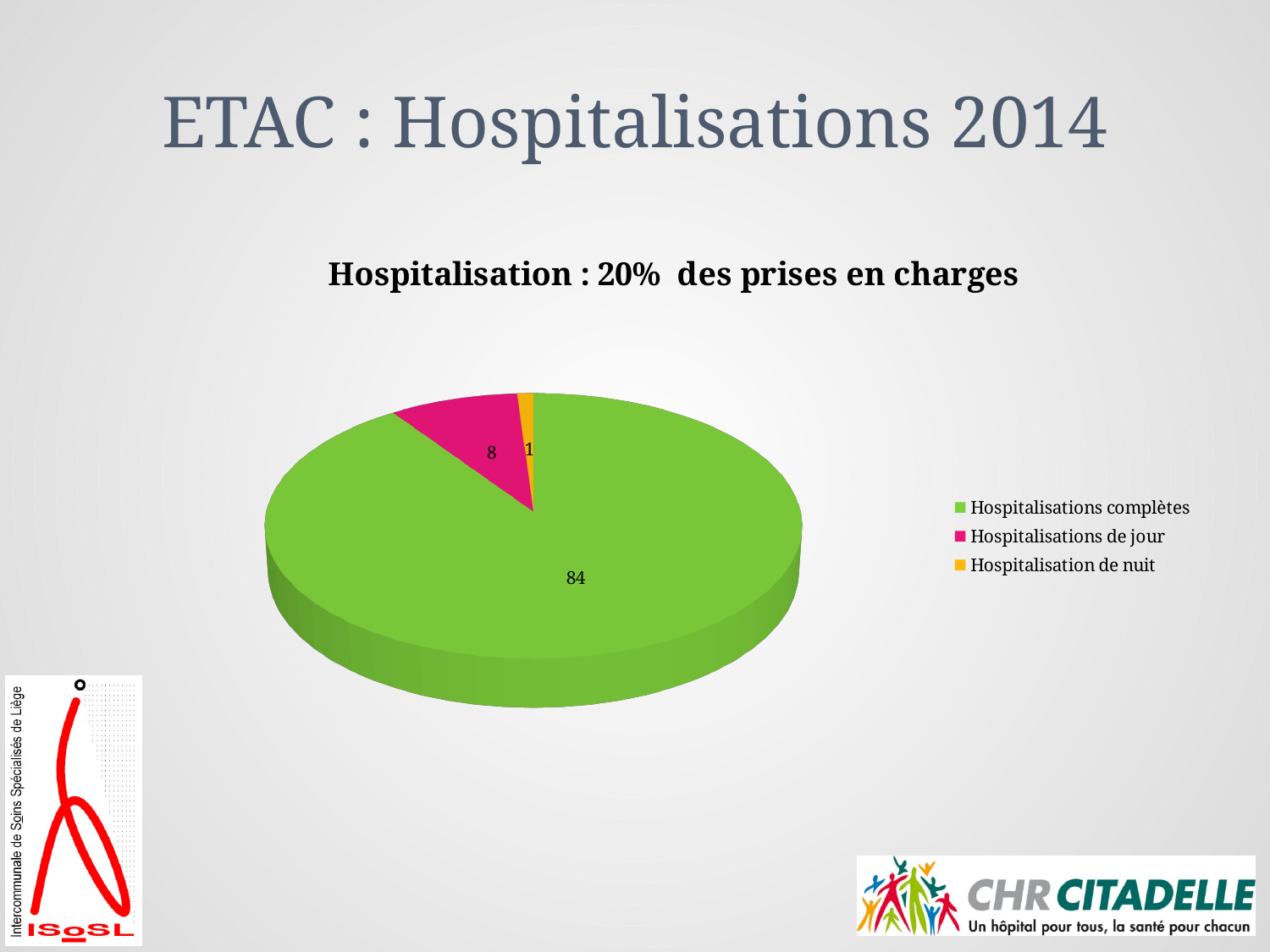
What value is shown for Hospitalisation de nuit? 1 How many categories does the pie chart show? 3 What value is shown for Hospitalisations complètes? 84 What kind of chart is shown on the slide? Pie chart What is the difference between the values for Hospitalisations complètes and Hospitalisations de jour? 76 What is the difference between the values for Hospitalisations de jour and Hospitalisation de nuit? 7 What value is shown for Hospitalisations de jour? 8 What is the title of the chart? Hospitalisation : 20% des prises en charges What is the total of all the slices in the pie chart? 93 Which category has the smallest slice of the pie? Hospitalisation de nuit Which is larger, Hospitalisations de jour or Hospitalisation de nuit? Hospitalisations de jour Which category has the largest slice of the pie? Hospitalisations complètes